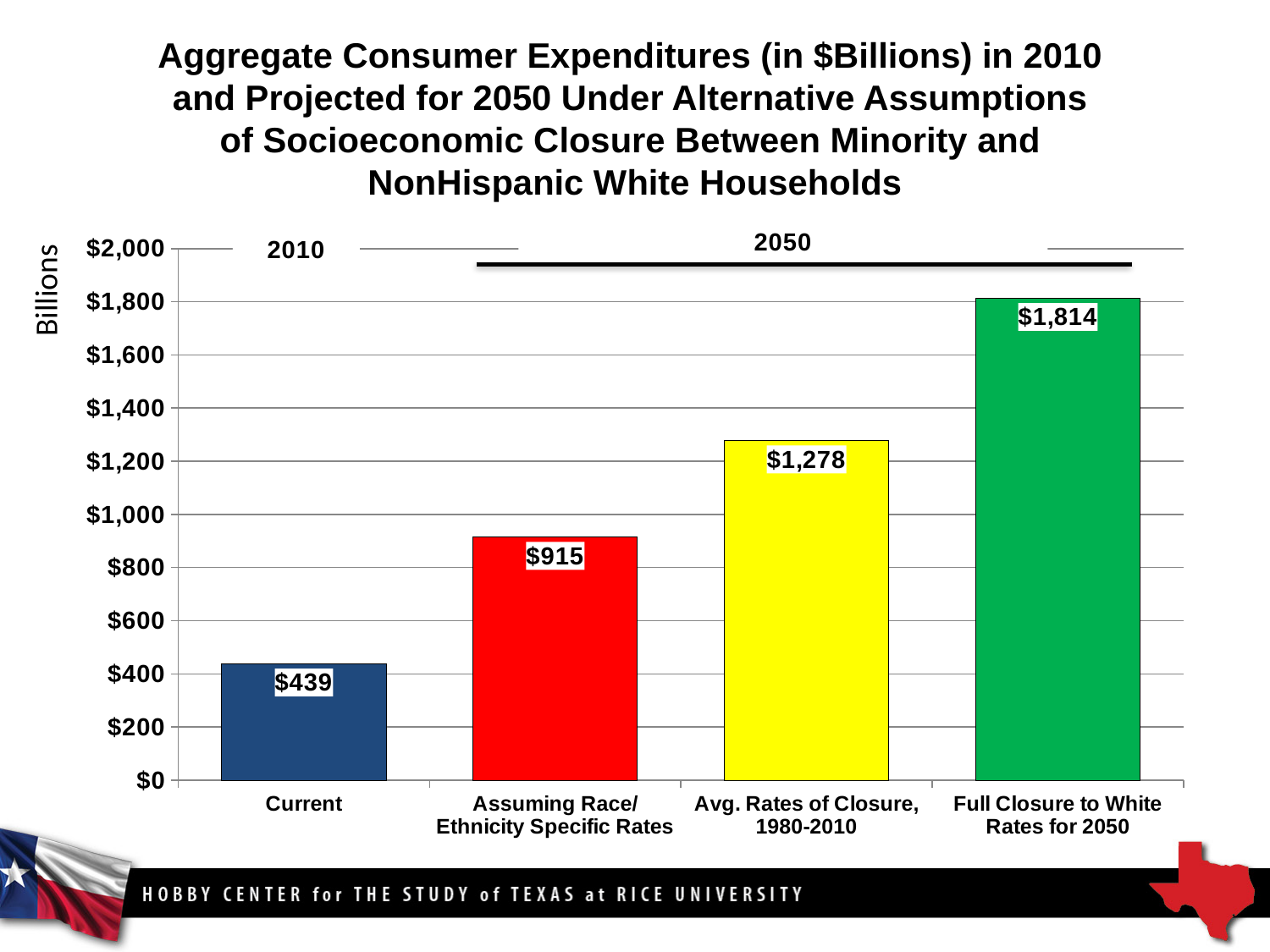
What is the value for Assuming Race/Ethnicity Specific Rates? $915 Which is larger, the value for Assuming Race/Ethnicity Specific Rates or the value for Avg. Rates of Closure, 1980-2010? Avg. Rates of Closure, 1980-2010 What is the value for Full Closure to White Rates for 2050? $1,814 What is the value for Current? $439 What kind of chart is shown on the slide? Bar chart What is the difference between the values for Avg. Rates of Closure, 1980-2010 and Assuming Race/Ethnicity Specific Rates? $363 What is the label on the vertical axis? Billions What is the difference between the values for Full Closure to White Rates for 2050 and Current? $1,375 Which category has the lowest value? Current What is the value for Avg. Rates of Closure, 1980-2010? $1,278 Which category has the highest value? Full Closure to White Rates for 2050 How many categories are shown on the chart? 4